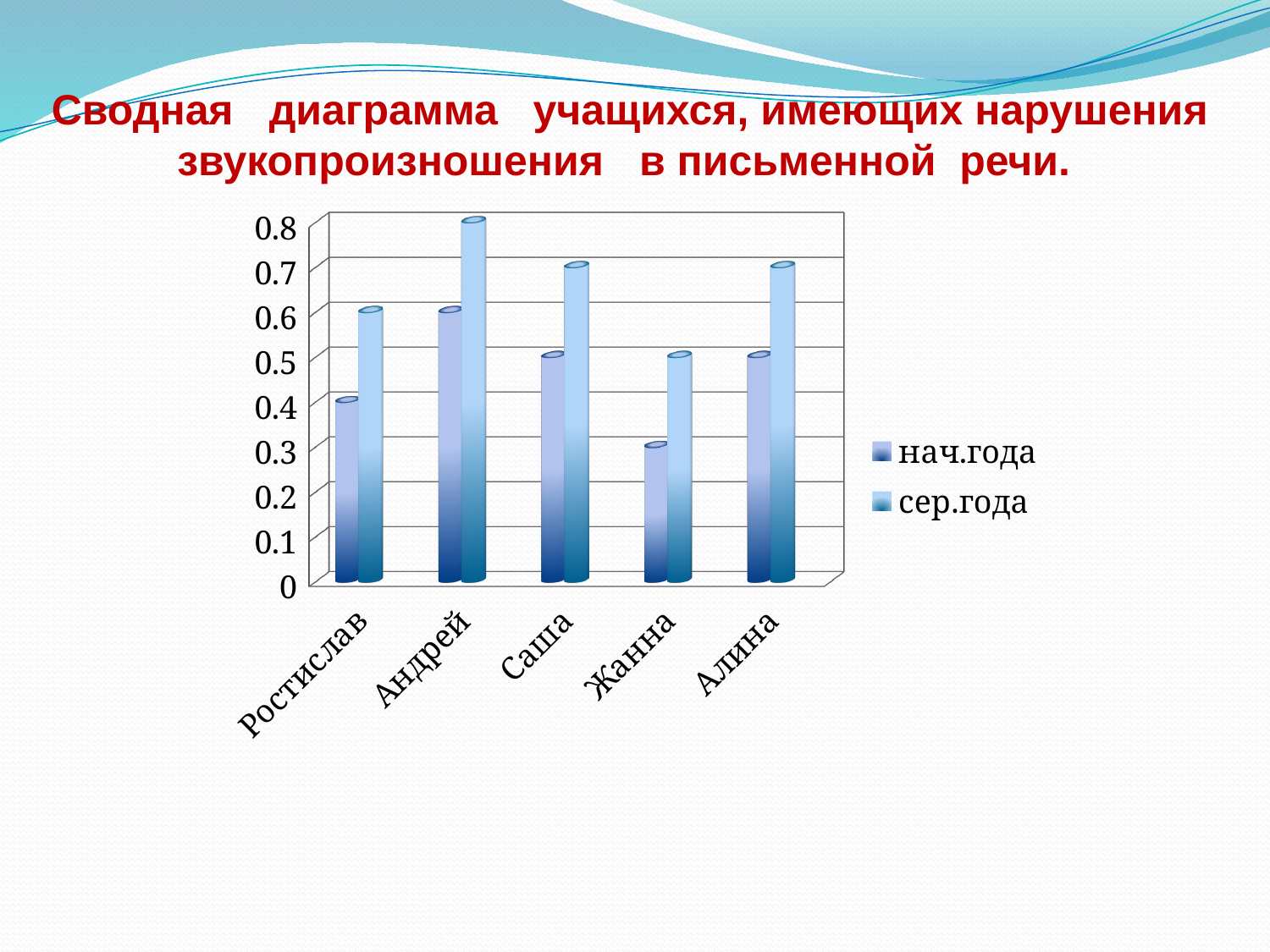
What is the value for Ростислав in the нач.года series? 0.4 Which is larger: the нач.года value for Андрей or the нач.года value for Ростислав? Андрей Which student has the lowest value in the нач.года series? Жанна What is the difference between the сер.года and нач.года values for Андрей? 0.2 What is the value for Жанна in the нач.года series? 0.3 Which student has the highest value in the сер.года series? Андрей Is the нач.года value for Жанна greater or less than 0.4? less How many series does the legend list? 2 What is the value for Андрей in the сер.года series? 0.8 What kind of chart is shown on the slide? bar chart How many students (categories) are shown on the x axis of the chart? 5 What are the two series named in the legend? нач.года and сер.года